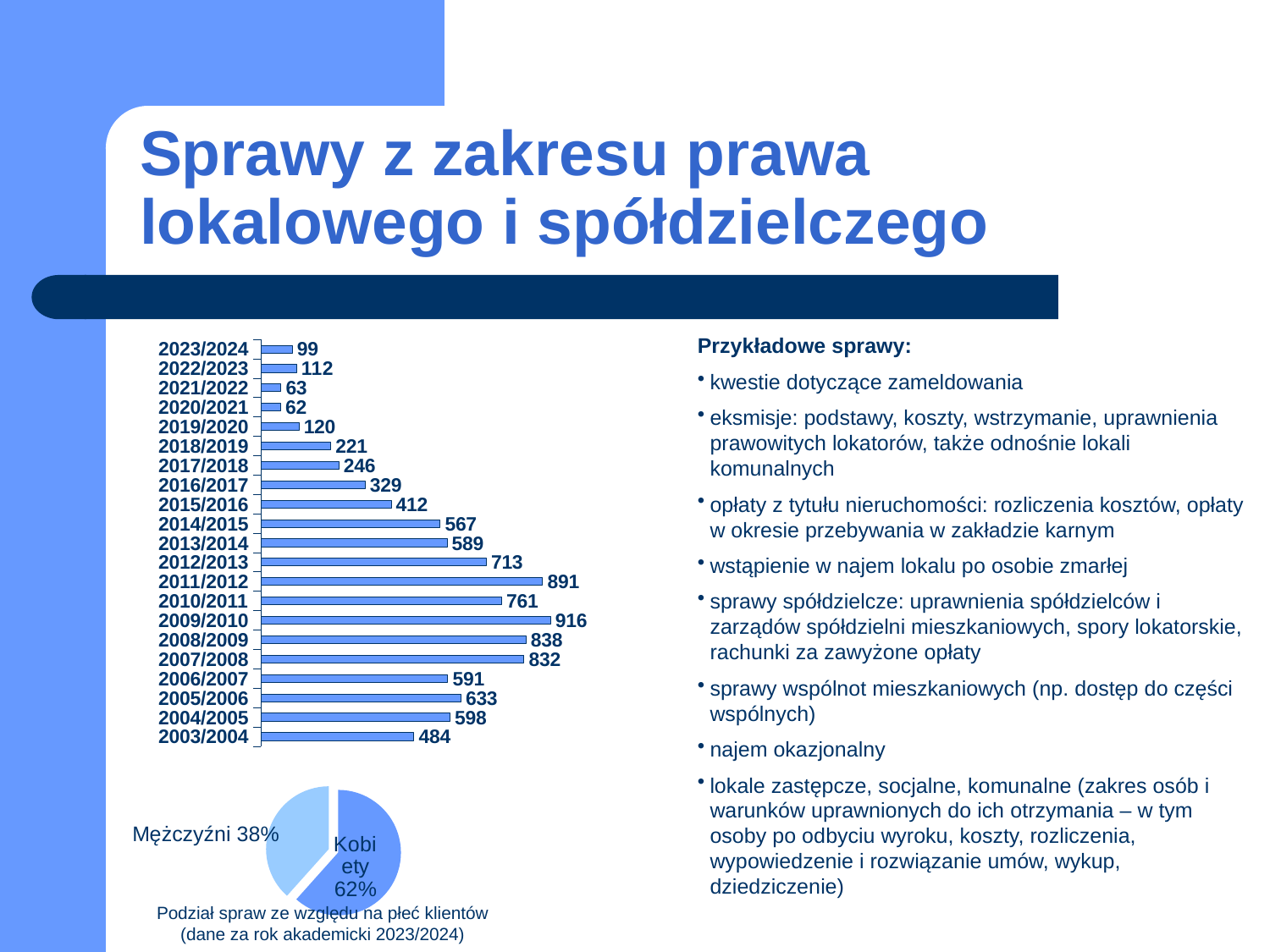
In the bar chart, what is the difference between the values for 2011/2012 and 2010/2011? 130 In the bar chart, what is the value for 2003/2004? 484 In the bar chart, which academic year has the highest value? 2009/2010 What kind of chart is the chart at the bottom left of the slide? pie chart In the pie chart, what share of cases is for Kobiety? 62% In the pie chart, what share of cases is for Mężczyźni? 38% In the bar chart, what is the value for 2023/2024? 99 What kind of chart is the chart at the top left of the slide? bar chart In the bar chart, how many academic years are shown? 21 In the bar chart, which academic year has the lowest value? 2020/2021 In the bar chart, which is larger: the value for 2014/2015 or the value for 2013/2014? 2013/2014 In the bar chart, what is the value for 2009/2010? 916